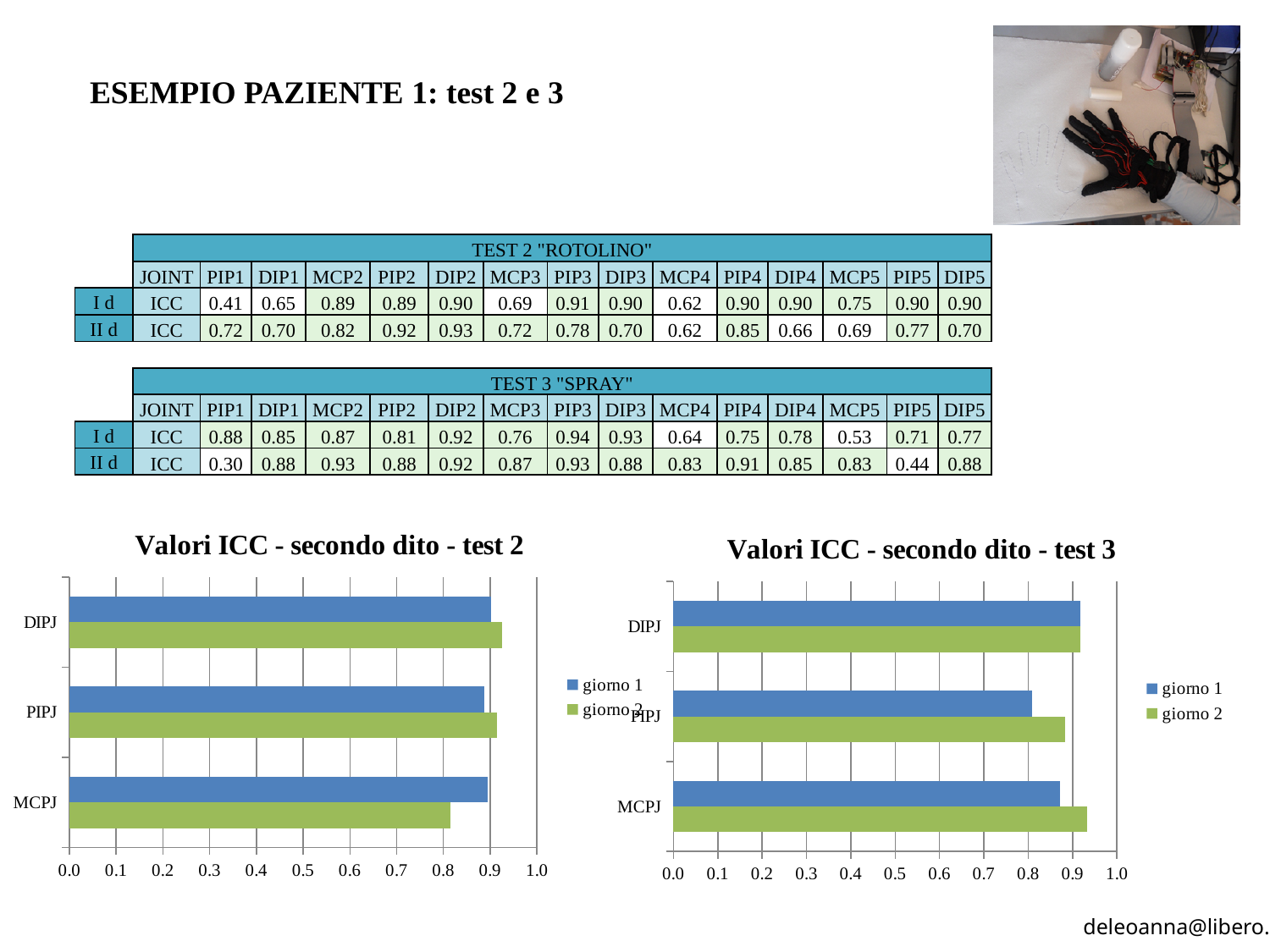
What kind of chart is "Valori ICC - secondo dito - test 2"? bar chart How many series does the legend of "Valori ICC - secondo dito - test 3" list? 2 In "Valori ICC - secondo dito - test 2", for MCPJ, which is larger: giorno 1 or giorno 2? giorno 1 In "Valori ICC - secondo dito - test 3", which joint has the lowest giorno 1 value? PIPJ In "Valori ICC - secondo dito - test 3", is the giorno 1 value for PIPJ greater or less than 0.9? less How many joint categories are shown on the y axis of "Valori ICC - secondo dito - test 2"? 3 In "Valori ICC - secondo dito - test 2", is the giorno 2 value for DIPJ greater or less than 0.9? greater In "Valori ICC - secondo dito - test 3", is the giorno 2 value for MCPJ greater or less than 0.9? greater What are the two legend entries in "Valori ICC - secondo dito - test 3"? giorno 1 and giorno 2 In "Valori ICC - secondo dito - test 2", which joint has the lowest giorno 2 value? MCPJ In "Valori ICC - secondo dito - test 3", for MCPJ, which is larger: giorno 1 or giorno 2? giorno 2